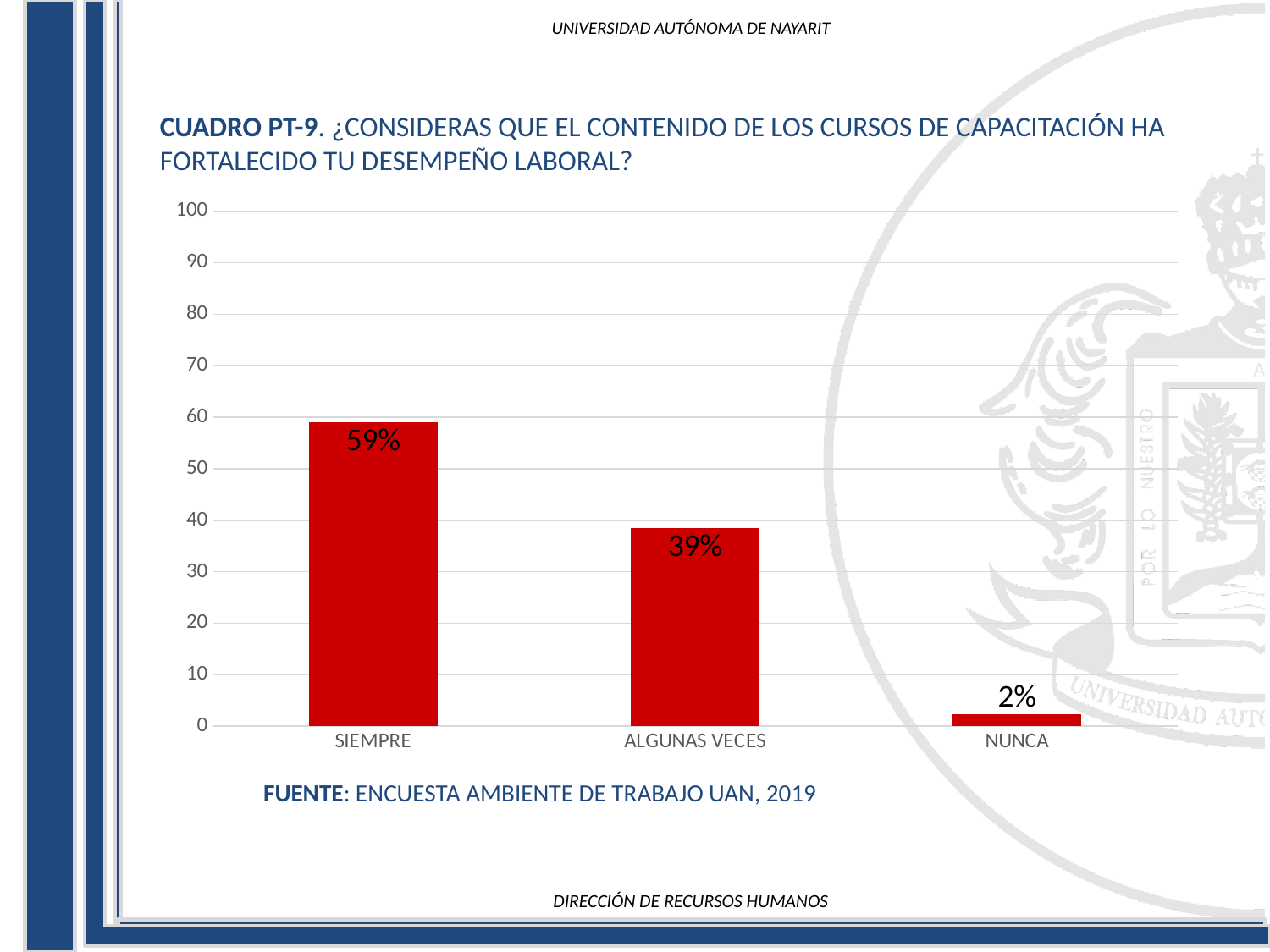
Which is larger, the value for ALGUNAS VECES or the value for NUNCA? ALGUNAS VECES What is the value for ALGUNAS VECES? 39% Which category has the highest value? SIEMPRE What kind of chart is shown on the slide? bar chart What is the value for NUNCA? 2% How many categories are shown on the x axis? 3 Is the value for SIEMPRE greater or less than 50? greater Which category has the lowest value? NUNCA What is the difference between the values for ALGUNAS VECES and NUNCA? 37% Do the values rise or fall from left to right along the x axis? fall What is the difference between the values for SIEMPRE and ALGUNAS VECES? 20% What is the value for SIEMPRE? 59%